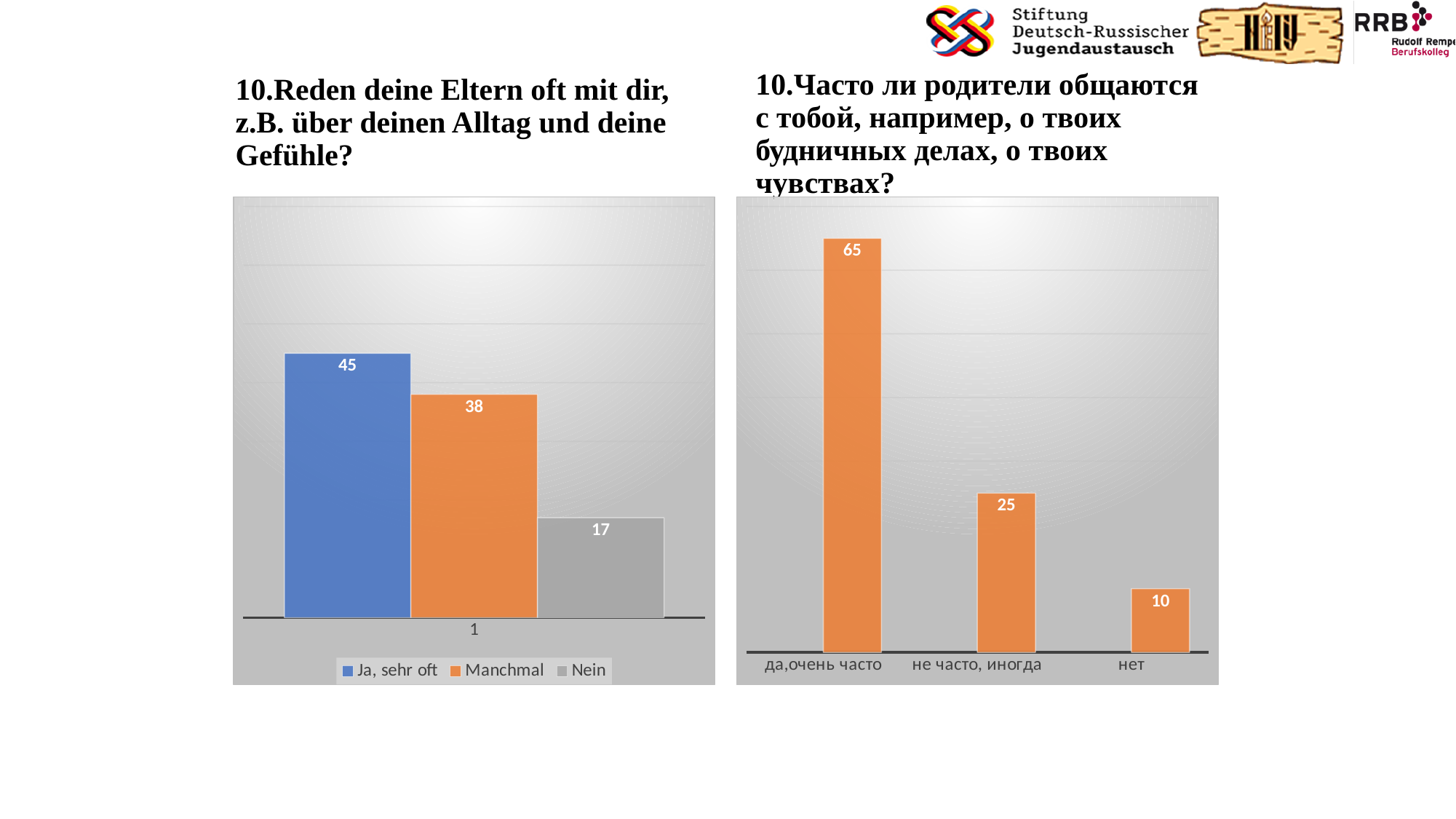
In the left chart, how many series does the legend list? 3 In the right chart, what is the value for "не часто, иногда"? 25 In the left chart, what is the value for "Ja, sehr oft"? 45 In the right chart, which category has the lowest value? нет In the left chart, what is the difference between "Ja, sehr oft" and "Nein"? 28 In the left chart, what is the value for "Nein"? 17 What kind of chart is the right chart? Bar chart In the left chart, what is the value for "Manchmal"? 38 In the left chart, which series has the highest value? Ja, sehr oft In the right chart, how many categories are shown on the x axis? 3 In the right chart, what is the difference between "да,очень часто" and "не часто, иногда"? 40 In the right chart, what is the value for "да,очень часто"? 65